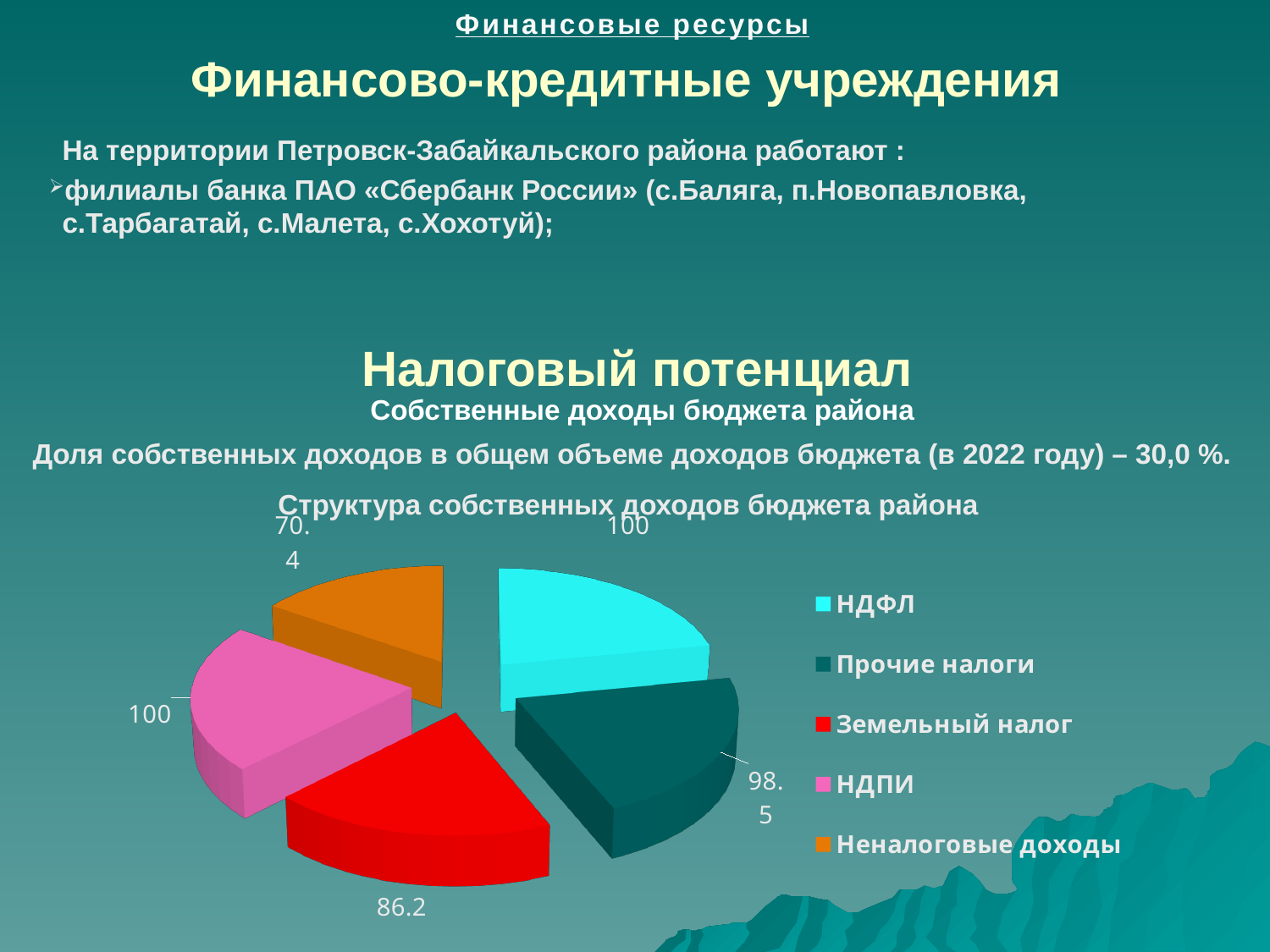
Which is larger in the pie chart: Земельный налог or Неналоговые доходы? Земельный налог What is the difference between the НДПИ value and the Земельный налог value in the pie chart? 13.8 What is the value shown for the Земельный налог slice in the pie chart? 86.2 What is the difference between the Прочие налоги value and the Неналоговые доходы value in the pie chart? 28.1 Which category has the smallest value in the pie chart? Неналоговые доходы What is the value shown for the НДФЛ slice in the pie chart? 100 What is the value shown for the Прочие налоги slice in the pie chart? 98.5 How many entries does the legend of the pie chart list? 5 What type of chart is shown on the slide? Pie chart What is the title of the chart on the slide? Структура собственных доходов бюджета района How many slices does the pie chart have? 5 What is the value shown for the Неналоговые доходы slice in the pie chart? 70.4